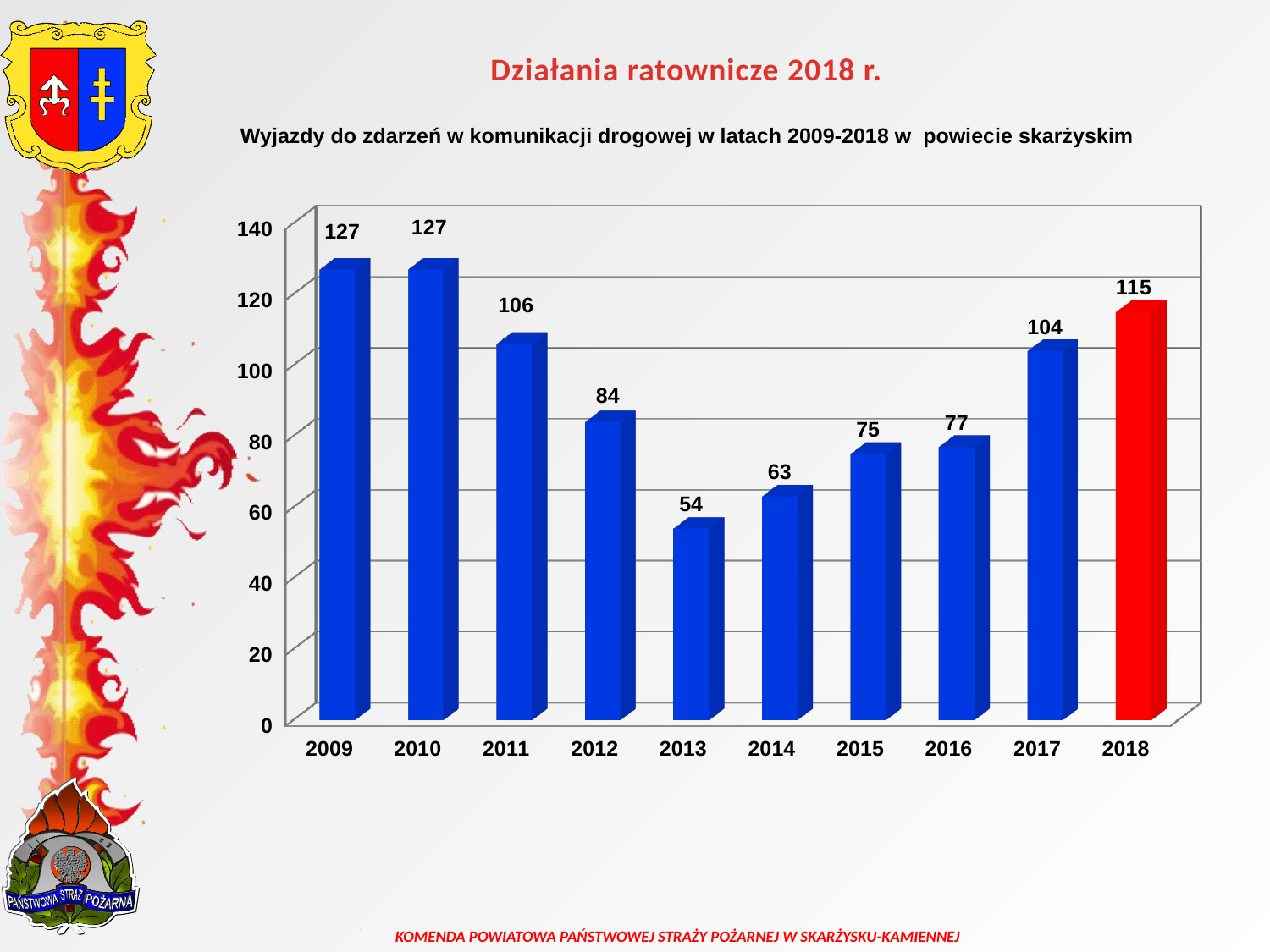
What is the value for 2017? 104 What is the difference between the values for 2011 and 2012? 22 What is the difference between the values for 2018 and 2017? 11 Which bar is coloured red instead of blue? 2018 What is the value for 2013? 54 What is the value for 2018? 115 How many years are shown on the x axis? 10 What kind of chart is shown on the slide? bar chart Do the values rise or fall from 2013 to 2018? rise Which year has the lowest value? 2013 Is the value for 2014 greater or less than 80? less Which is larger, the value for 2015 or the value for 2016? 2016